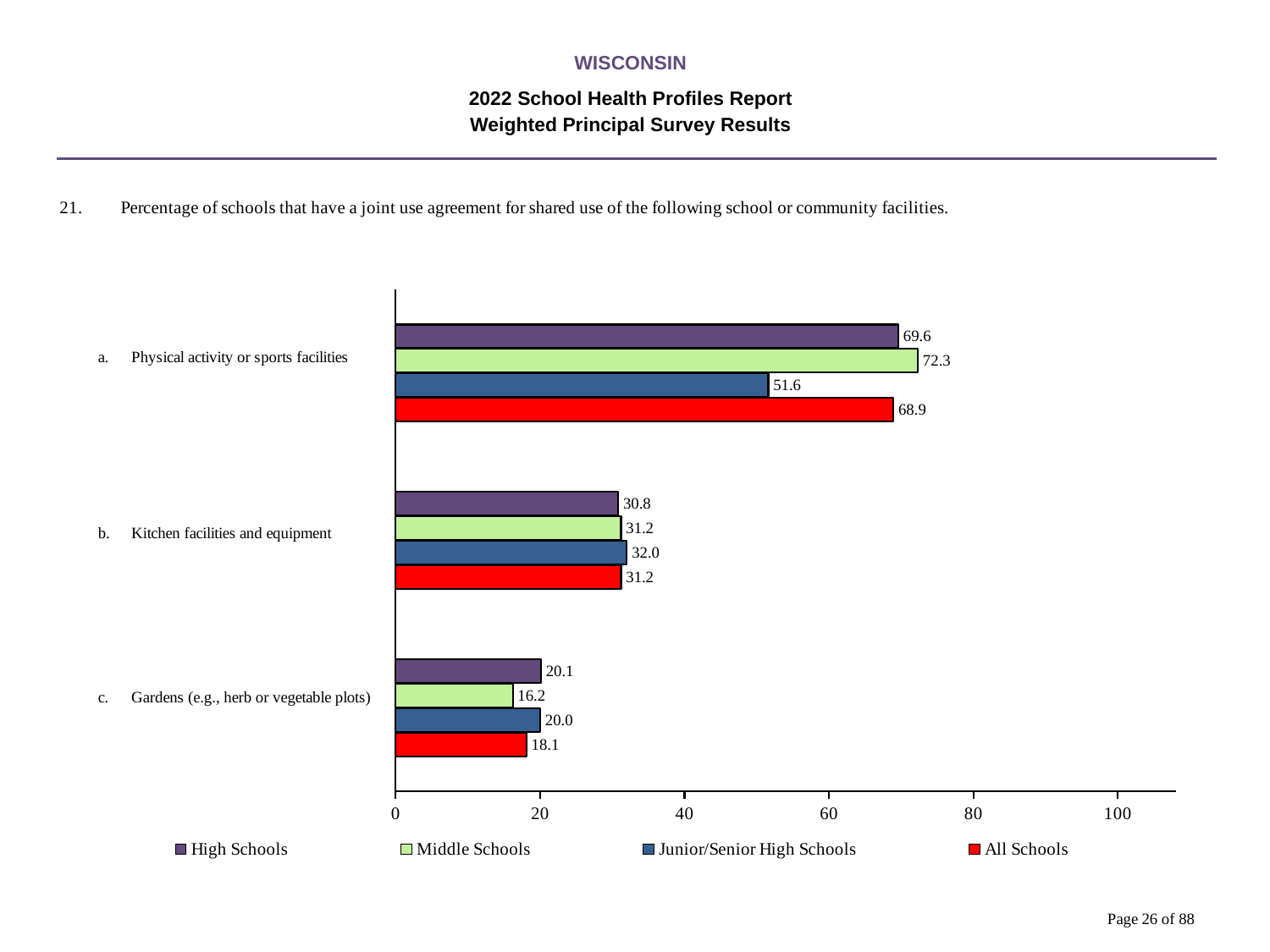
Which is larger for Kitchen facilities and equipment: the High Schools value or the Junior/Senior High Schools value? Junior/Senior High Schools Which school type has the highest value for Physical activity or sports facilities? Middle Schools How many facility categories are shown in the chart? 3 What is the value for All Schools for Gardens (e.g., herb or vegetable plots)? 18.1 What is the difference between the High Schools and Junior/Senior High Schools values for Physical activity or sports facilities? 18.0 What is the value for High Schools for Gardens (e.g., herb or vegetable plots)? 20.1 What is the value for Middle Schools for Physical activity or sports facilities? 72.3 How many series does the legend list? 4 Is the All Schools value for Physical activity or sports facilities greater or less than 60? greater What is the value for Junior/Senior High Schools for Kitchen facilities and equipment? 32.0 What kind of chart is shown on the slide? Bar chart Which school type has the lowest value for Gardens (e.g., herb or vegetable plots)? Middle Schools